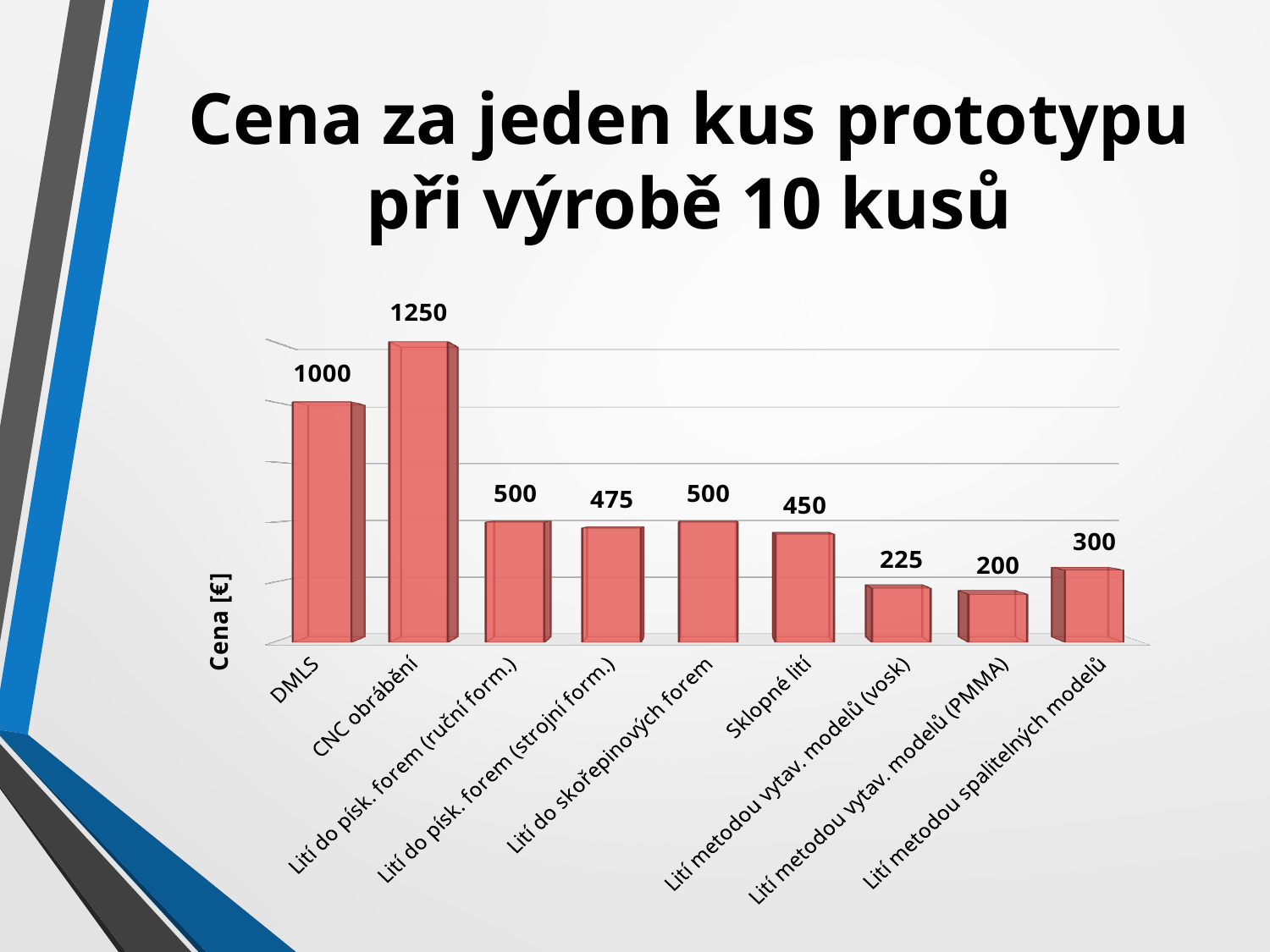
Which category has the highest value? CNC obrábění What is the value for CNC obrábění? 1250 What kind of chart is shown on the slide? bar chart What is the value for Lití metodou vytav. modelů (PMMA)? 200 Which is larger, the value for Sklopné lití or the value for Lití metodou spalitelných modelů? Sklopné lití What is the value for Sklopné lití? 450 How many categories are shown in the chart? 9 What is the value for DMLS? 1000 What is the difference between the values for CNC obrábění and DMLS? 250 What is the difference between the values for Lití do písk. forem (ruční form.) and Lití do písk. forem (strojní form.)? 25 Which category has the lowest value? Lití metodou vytav. modelů (PMMA) What is the label of the vertical axis? Cena [€]